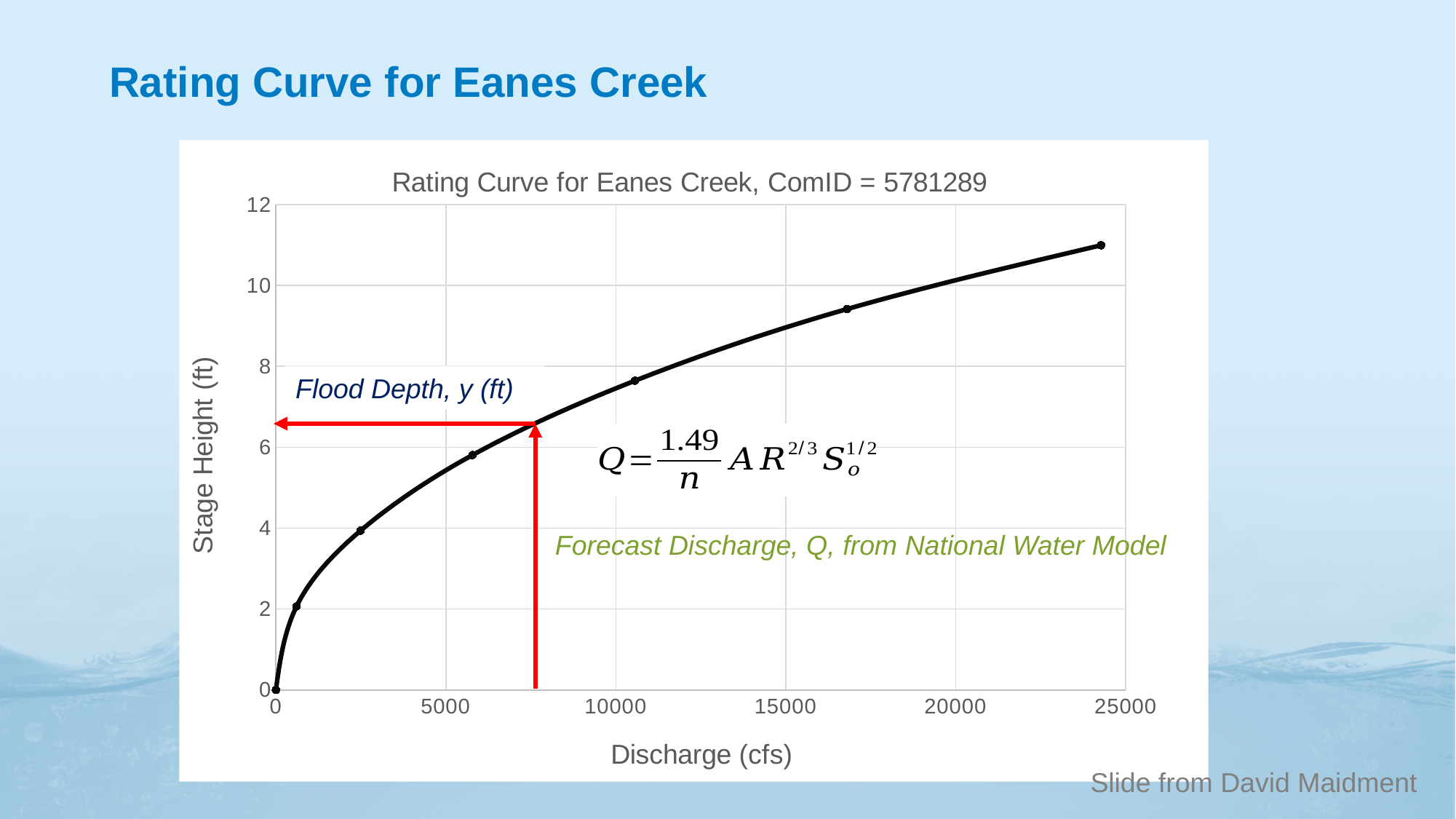
Which has the larger stage height: a discharge of 5000 cfs or a discharge of 20000 cfs? 20000 cfs What kind of chart is shown on the slide? line chart Is the highest stage height plotted on the curve greater or less than 10 ft? greater What is the largest discharge value labelled on the x axis? 25000 Is the stage height at a discharge of 15000 cfs greater or less than 8 ft? greater Is the stage height at a discharge of 2500 cfs greater or less than 6 ft? less Does the stage height rise or fall as discharge increases along the x axis? rises What is the title printed above the chart? Rating Curve for Eanes Creek, ComID = 5781289 What quantity is plotted on the vertical axis of the chart? Stage Height (ft) What is the stage height at a discharge of 0 cfs? 0